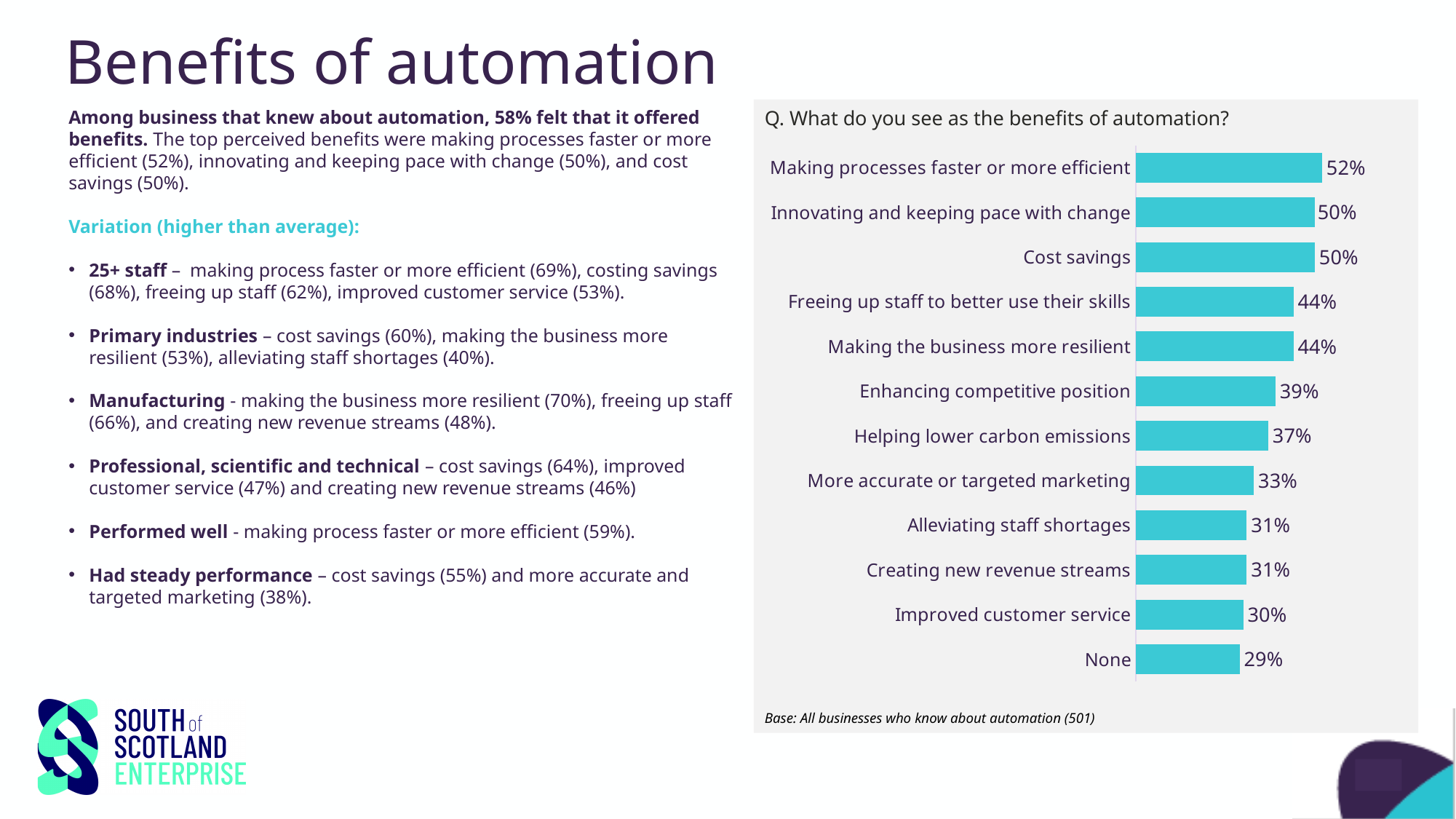
What percentage of businesses see making processes faster or more efficient as a benefit of automation? 52% What kind of chart is shown on the slide? Bar chart What is the difference between the values for Cost savings and Improved customer service? 20 percentage points What is the value for Helping lower carbon emissions? 37% Which benefit has the highest percentage in the chart? Making processes faster or more efficient Which is larger: the value for Enhancing competitive position or the value for Alleviating staff shortages? Enhancing competitive position What is the value for More accurate or targeted marketing? 33% What is the difference between the values for Freeing up staff to better use their skills and Creating new revenue streams? 13 percentage points What percentage selected None as a benefit of automation? 29% What question is the chart based on, as shown in its title? Q. What do you see as the benefits of automation? How many categories are shown in the chart? 12 Which category has the lowest percentage in the chart? None